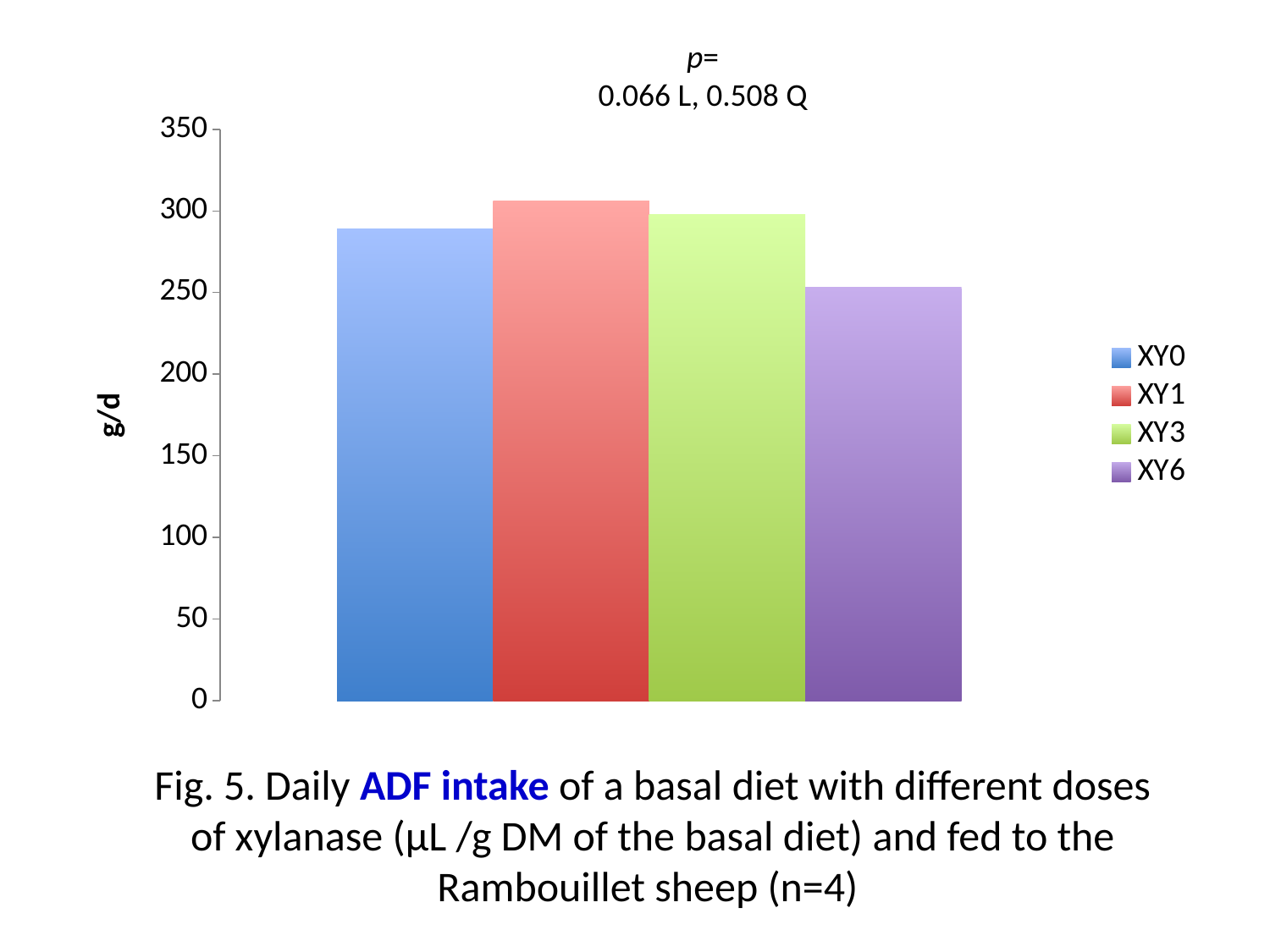
Is the value for XY6 greater or less than 300? less How many entries does the legend list? 4 How many bars are plotted in the chart? 4 Which is larger, the value for XY0 or the value for XY6? XY0 Which treatment has the highest daily ADF intake? XY1 Which treatment has the lowest daily ADF intake? XY6 Is the value for XY0 greater or less than 250? greater What p-values are printed above the chart? 0.066 L, 0.508 Q Is the value for XY3 greater or less than 250? greater What is the label on the vertical axis? g/d What kind of chart is shown on the slide? bar chart